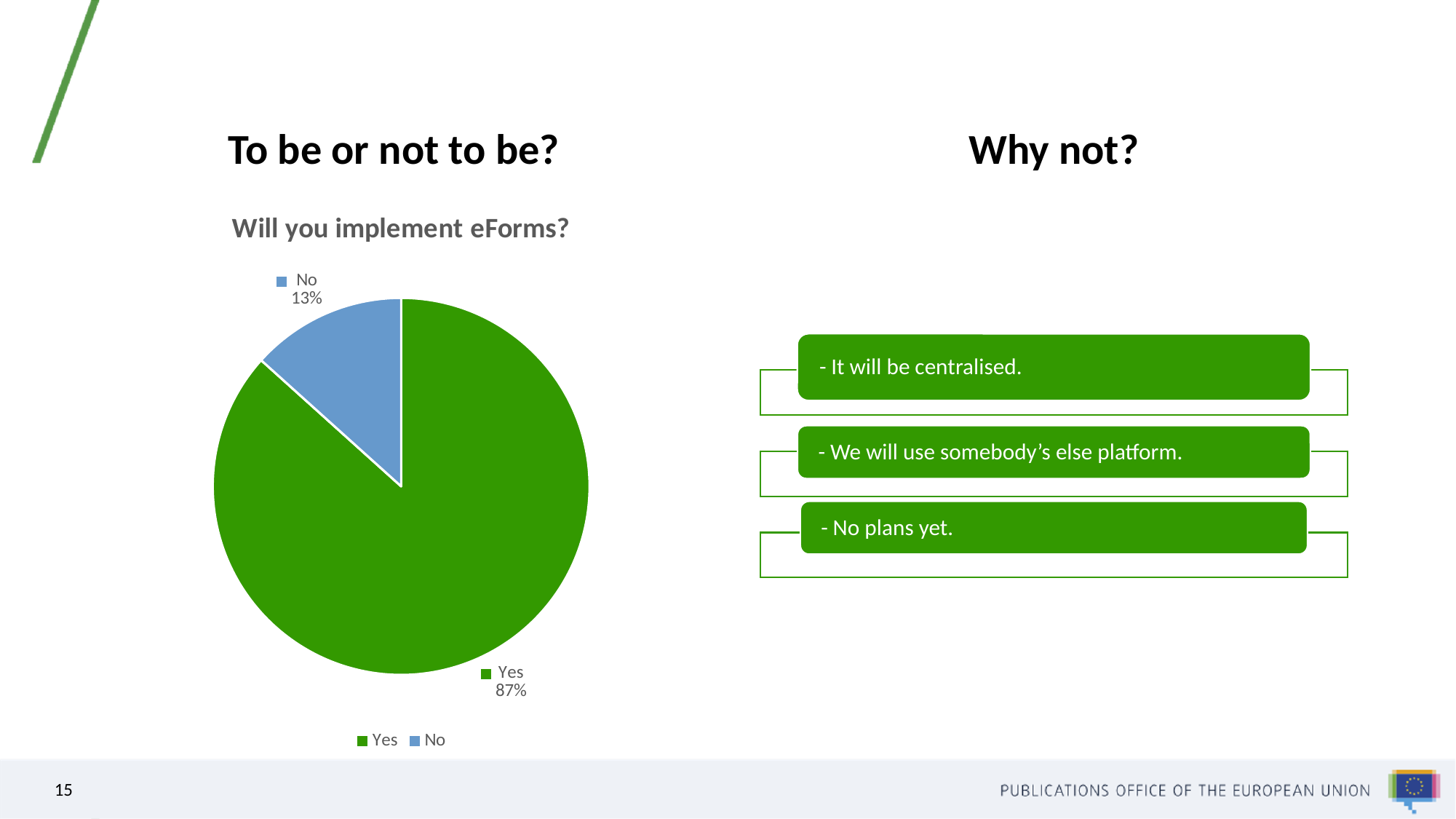
How many entries does the pie chart legend list? 2 What percentage of respondents answered No to "Will you implement eForms?"? 13% What is the difference in percentage points between the Yes and No slices? 74 Which slice of the pie chart is the largest? Yes Which is larger in the pie chart, Yes or No? Yes What colour is the Yes slice of the pie chart? Green Which slice of the pie chart is the smallest? No What is the title of the pie chart? Will you implement eForms? What percentage of respondents answered Yes to "Will you implement eForms?"? 87% How many slices does the pie chart have? 2 What type of chart is shown on the slide? Pie chart What share of the pie does the No slice represent? 13%